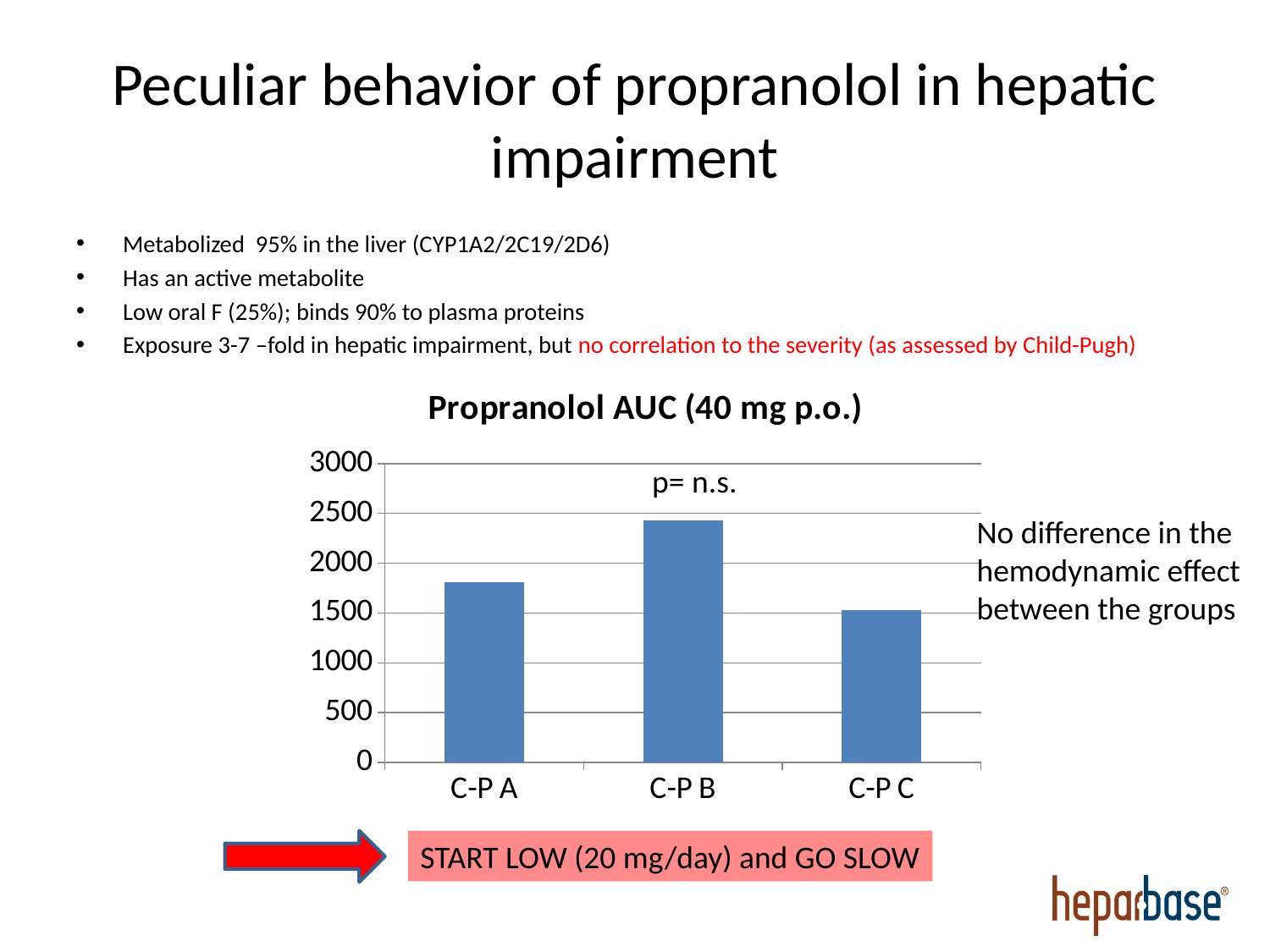
Which is larger, the value for C-P A or the value for C-P C? C-P A Which category has the highest bar in the chart? C-P B What is the title of the chart? Propranolol AUC (40 mg p.o.) Is the value for C-P A greater or less than 1500? greater How many categories are shown on the x axis of the chart? 3 Which is larger, the value for C-P B or the value for C-P A? C-P B Is the value for C-P B greater or less than 2500? less What kind of chart is shown on the slide? bar chart Which category has the lowest bar in the chart? C-P C Is the value for C-P B greater or less than 2000? greater What p-value annotation is printed inside the chart area? p= n.s.